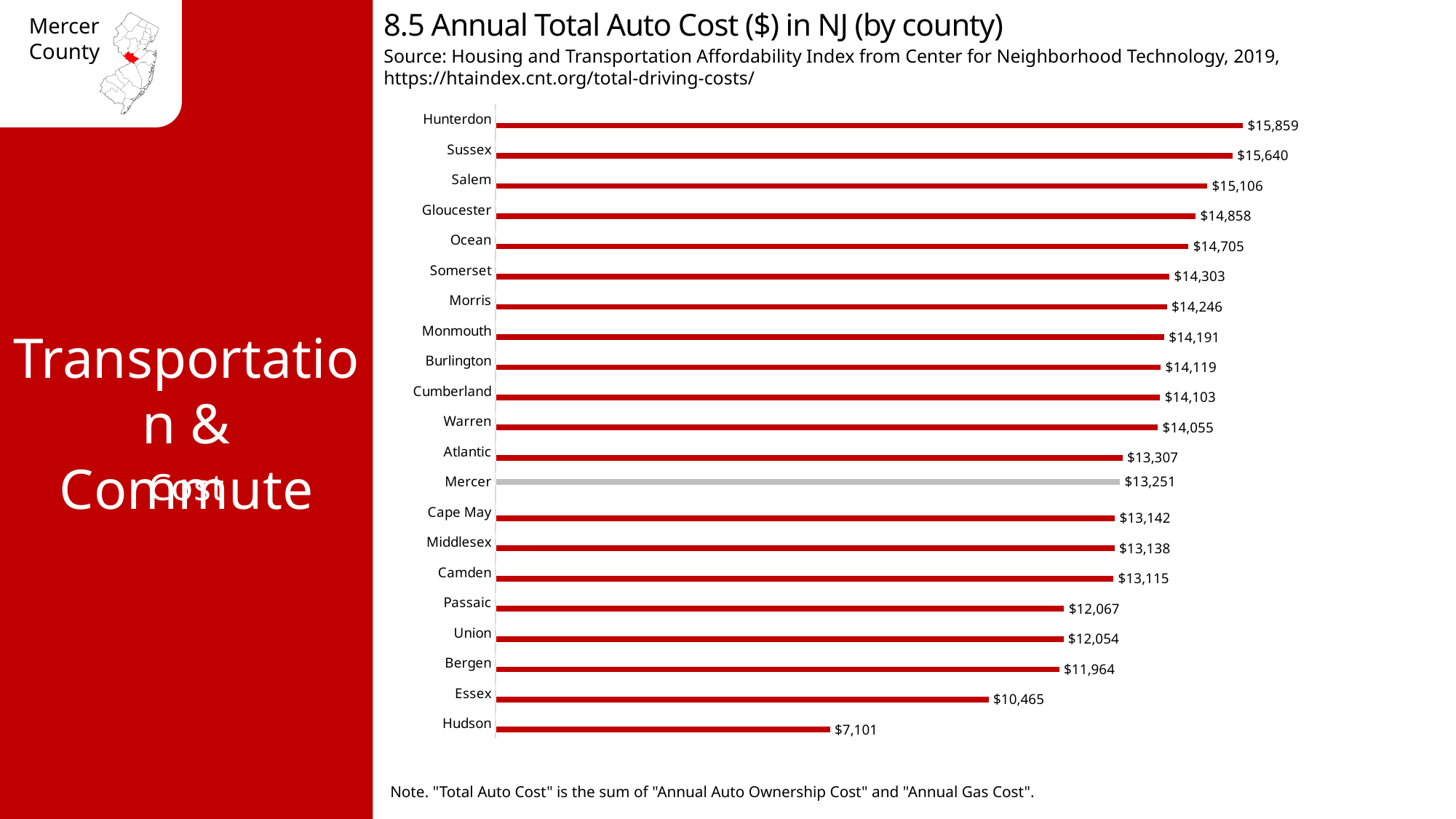
Which has a higher annual total auto cost, Essex or Passaic? Passaic Which county's bar is shown in gray instead of red? Mercer Which has a higher annual total auto cost, Ocean or Bergen? Ocean What is the annual total auto cost for Somerset County? $14,303 What kind of chart is shown on the slide? Bar chart How many counties are shown in the chart? 21 Which county has the lowest annual total auto cost? Hudson Which county has the highest annual total auto cost? Hunterdon What is the annual total auto cost for Mercer County? $13,251 What is the difference in annual total auto cost between Mercer and Essex? $2,786 What is the difference in annual total auto cost between Hunterdon and Hudson? $8,758 What is the annual total auto cost for Hudson County? $7,101